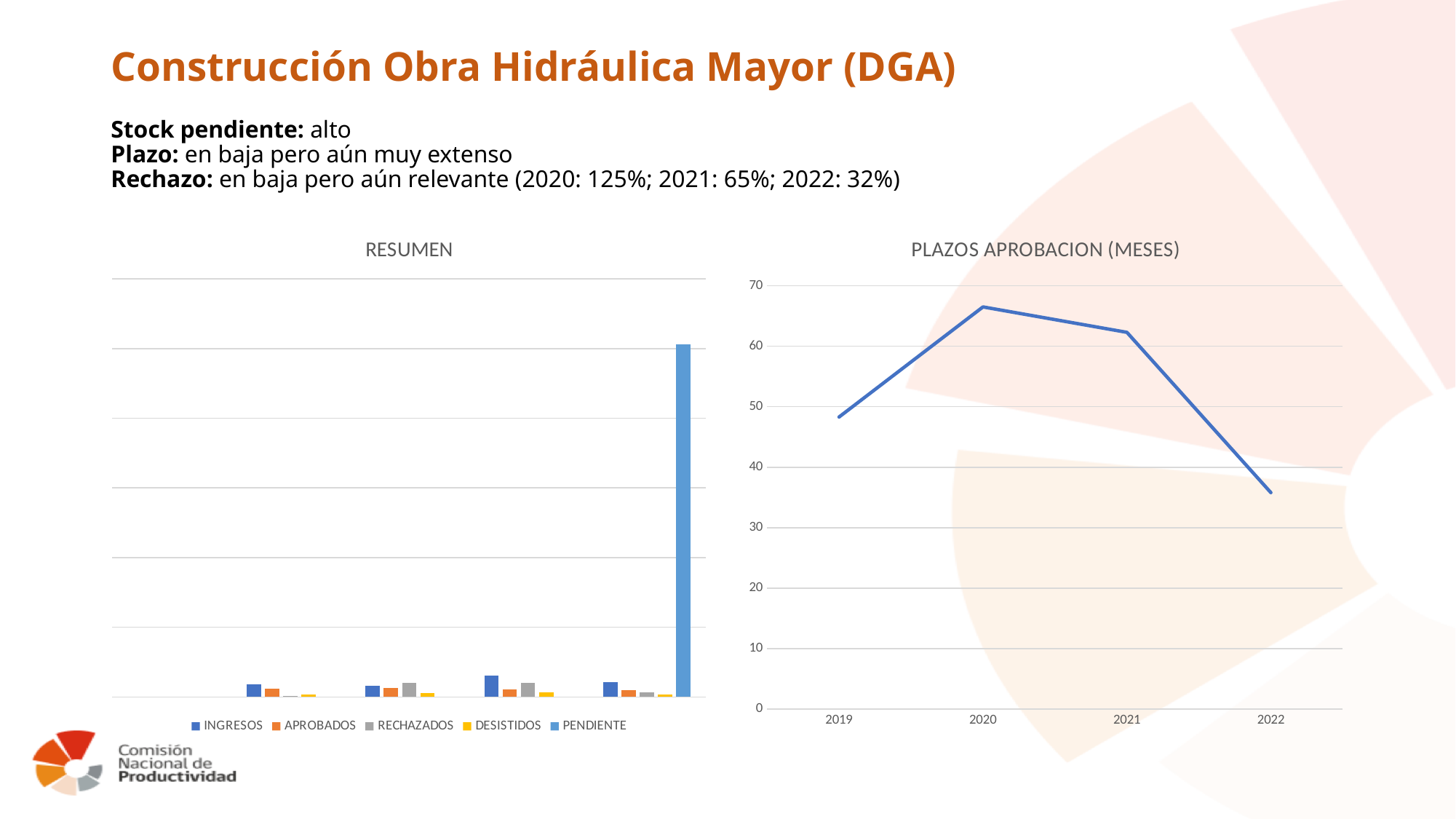
In the PLAZOS APROBACION (MESES) chart, which is larger, the value for 2019 or the value for 2022? 2019 In the PLAZOS APROBACION (MESES) chart, which year has the lowest value? 2022 What kind of chart is the RESUMEN chart on the left? bar chart In the RESUMEN chart, which series has by far the tallest bar? PENDIENTE In the PLAZOS APROBACION (MESES) chart, is the value for 2020 greater or less than 60? greater In the PLAZOS APROBACION (MESES) chart, which year has the highest value? 2020 In the PLAZOS APROBACION (MESES) chart, do the values rise or fall from 2020 to 2022? fall How many years are plotted on the x axis of the PLAZOS APROBACION (MESES) chart? 4 What kind of chart is the PLAZOS APROBACION (MESES) chart on the right? line chart How many series does the legend of the RESUMEN chart list? 5 What are the legend entries of the RESUMEN chart? INGRESOS, APROBADOS, RECHAZADOS, DESISTIDOS, PENDIENTE In the PLAZOS APROBACION (MESES) chart, is the value for 2022 greater or less than 40? less